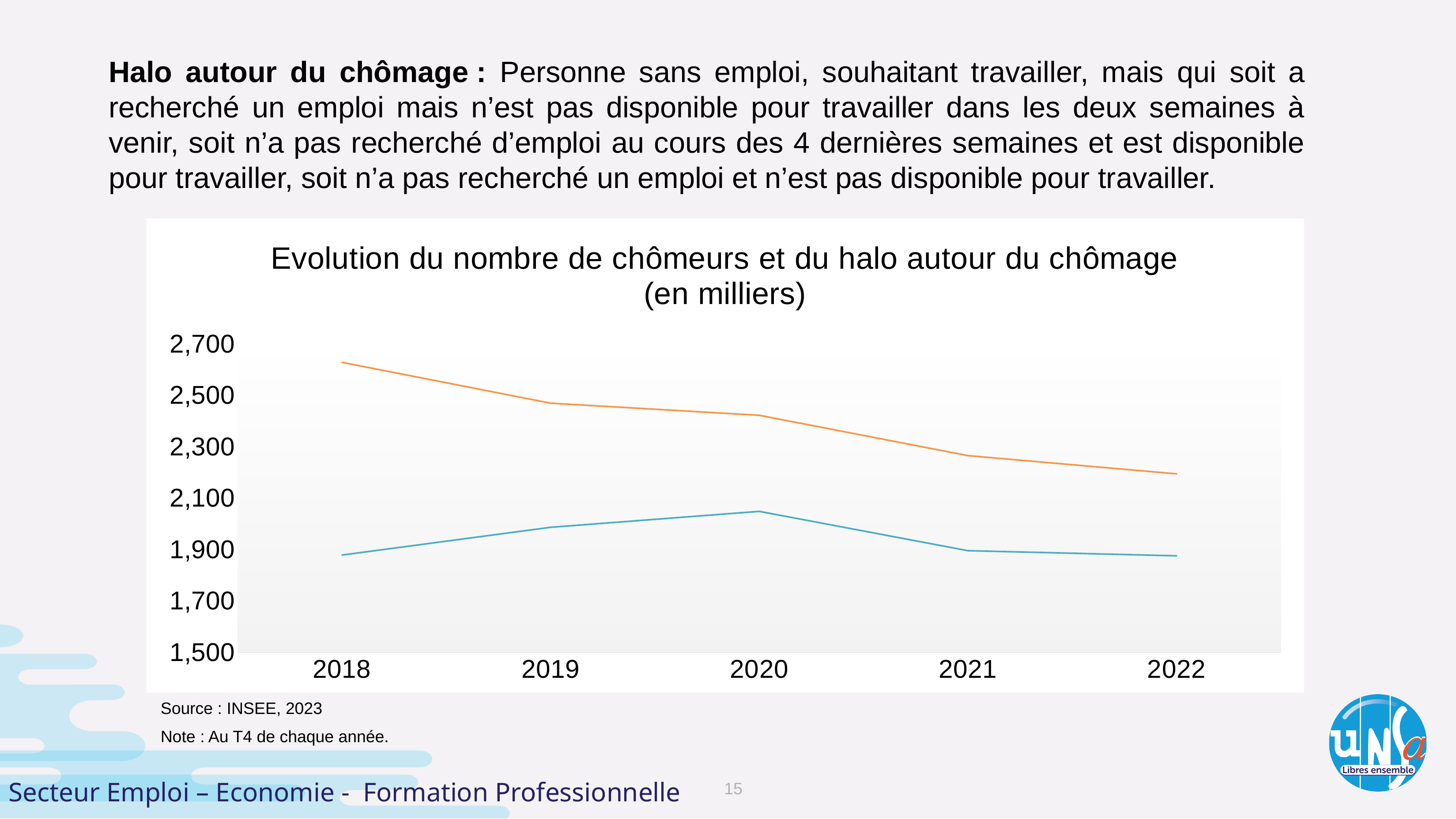
In which year is the orange line at its lowest? 2022 Does the orange line rise or fall from 2018 to 2022? fall How many years are shown on the x axis of the chart? 5 Is the value of the orange line in 2022 greater or less than 2,300? less How many lines are plotted on the chart? 2 What is the title of the chart? Evolution du nombre de chômeurs et du halo autour du chômage (en milliers) In 2020, which line has the higher value, the orange line or the blue line? the orange line In which year is the orange line at its highest? 2018 In which year does the blue line reach its highest point? 2020 Is the value of the orange line in 2018 greater or less than 2,500? greater What kind of chart is shown on the slide? line chart